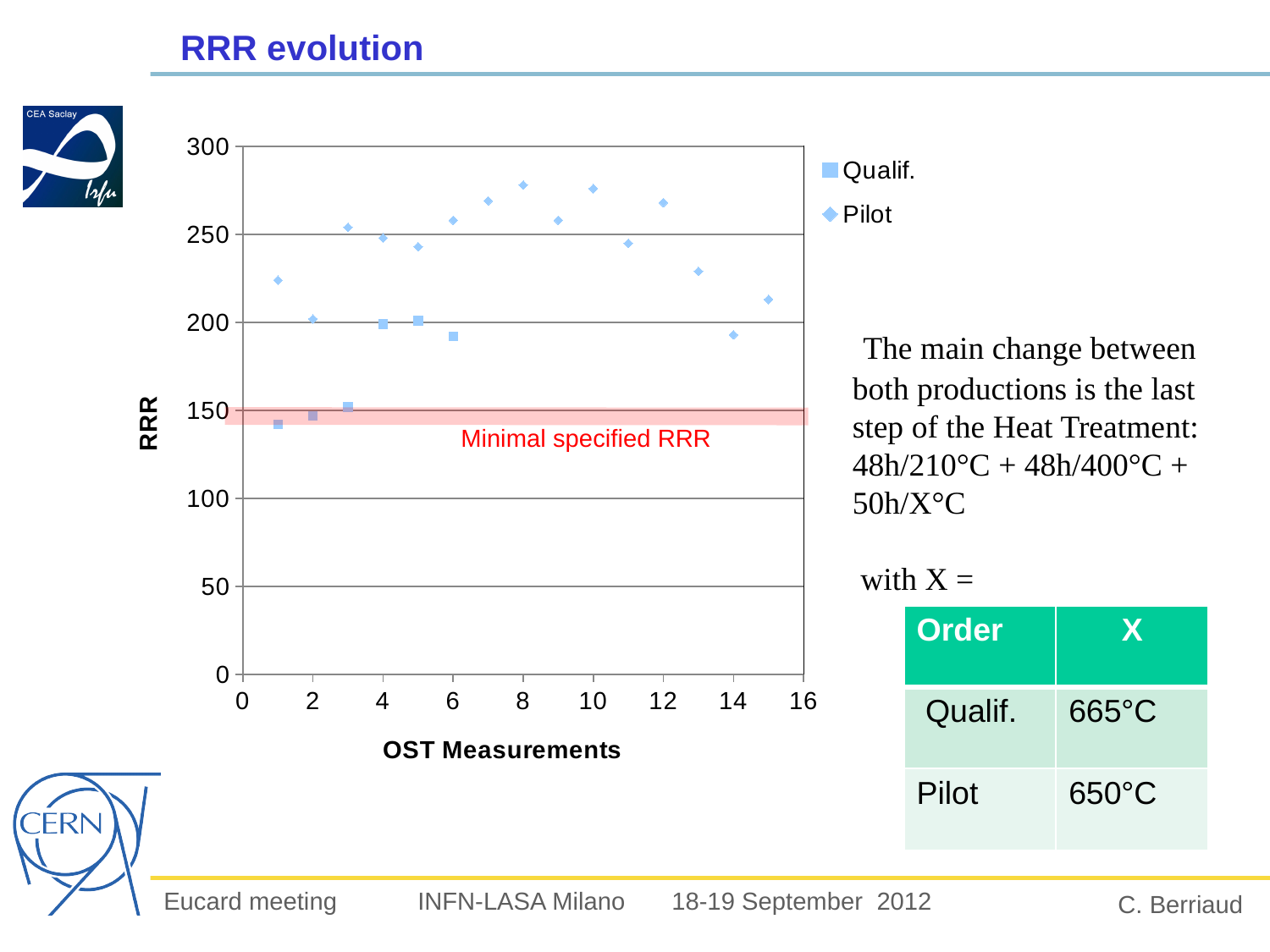
How many series does the legend list? 2 Is the Pilot value at OST measurement 8 greater or less than 250? greater How many Pilot data points are plotted on the chart? 15 What kind of chart is shown on the slide? scatter chart At OST measurement 3, which series has the larger RRR value, Qualif. or Pilot? Pilot Is the Qualif. value at OST measurement 1 greater or less than 150? less Is the Pilot value at OST measurement 15 greater or less than 200? greater For the Pilot series, is the RRR value larger at OST measurement 1 or at OST measurement 2? OST measurement 1 Do the Qualif. values rise or fall from OST measurement 1 to OST measurement 5? rise What is the title of the x axis of the chart? OST Measurements How many Qualif. data points are plotted on the chart? 6 What does the red band on the chart represent, according to its label? Minimal specified RRR